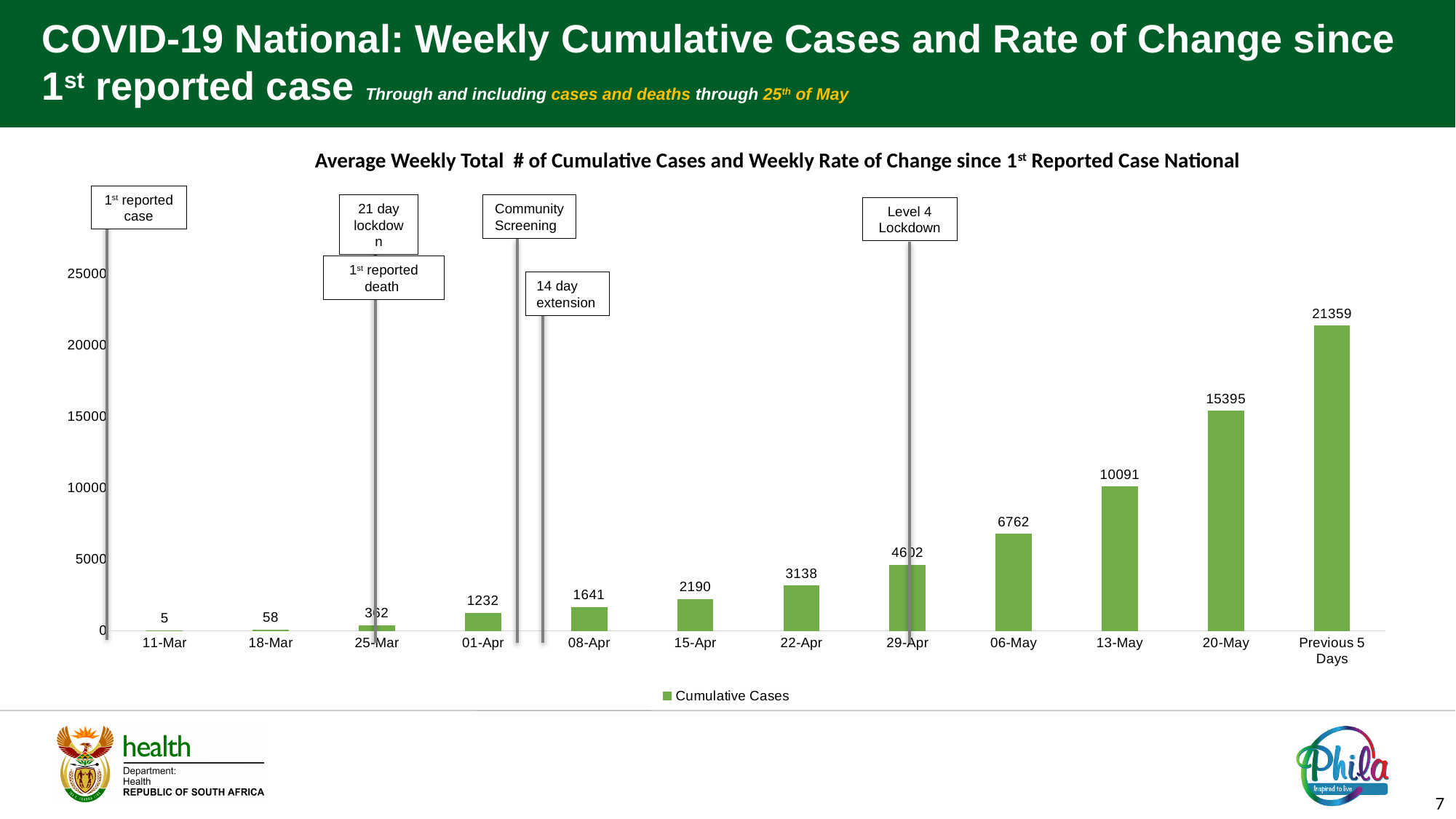
What type of chart is shown on the slide? bar chart Which category has the highest Cumulative Cases value? Previous 5 Days Which category has the lowest Cumulative Cases value? 11-Mar How many categories are shown on the x axis? 12 What is the value of Cumulative Cases for 13-May? 10091 What is the value of Cumulative Cases for 01-Apr? 1232 Is the value for 06-May greater or less than 5000? greater What is the value of Cumulative Cases for 18-Mar? 58 What is the difference in Cumulative Cases between 20-May and 13-May? 5304 How many series does the legend list? 1 What is the value of Cumulative Cases for Previous 5 Days? 21359 Which has a larger Cumulative Cases value, 22-Apr or 15-Apr? 22-Apr